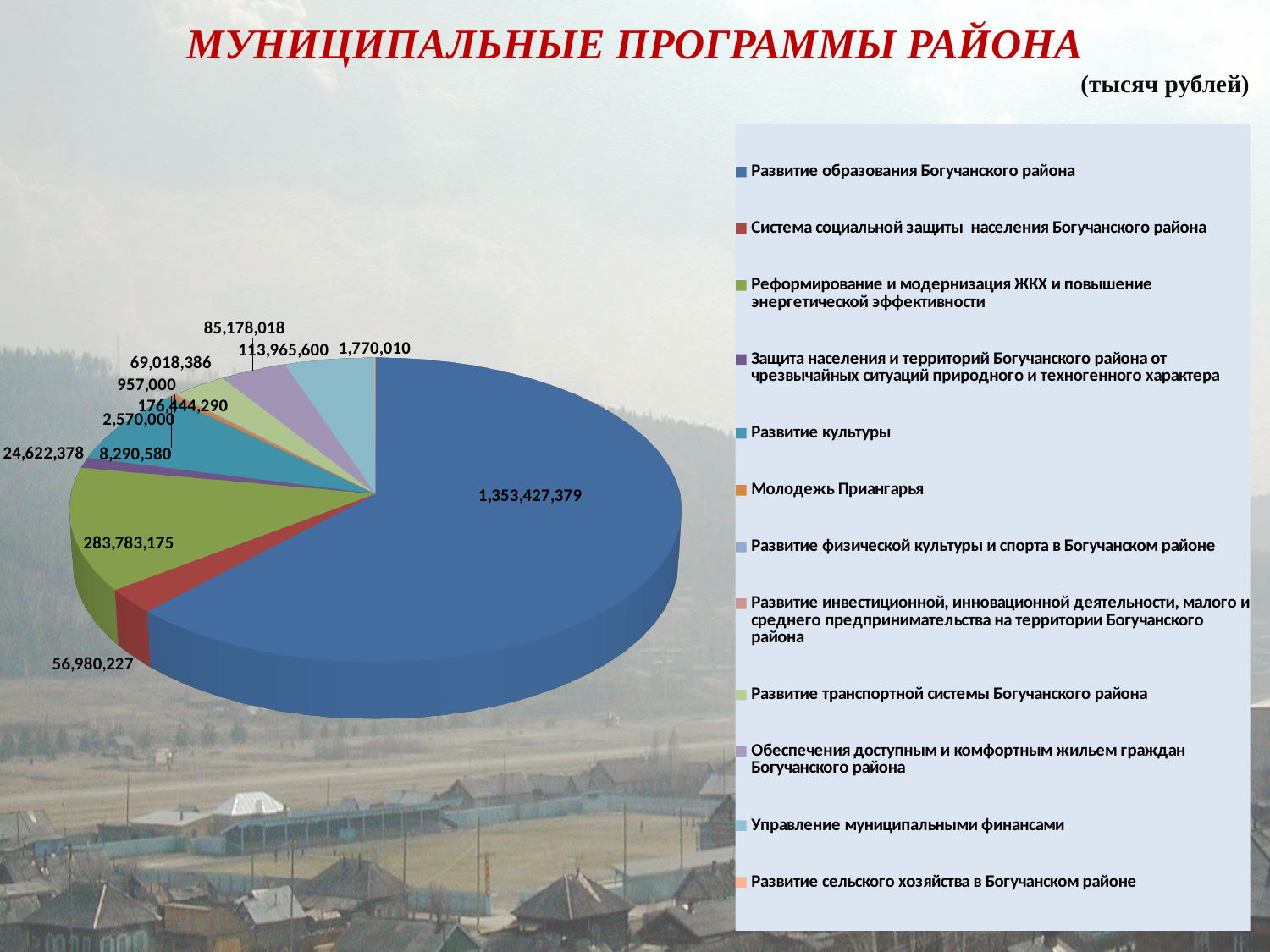
What is the value shown for Развитие образования Богучанского района? 1,353,427,379 What is the title of the chart on the slide? МУНИЦИПАЛЬНЫЕ ПРОГРАММЫ РАЙОНА What is the value shown for Система социальной защиты населения Богучанского района? 56,980,227 What type of chart is shown on the slide? pie chart What is the value shown for Реформирование и модернизация ЖКХ и повышение энергетической эффективности? 283,783,175 Which is larger: the value for Реформирование и модернизация ЖКХ or the value for Развитие культуры? Реформирование и модернизация ЖКХ What is the smallest value printed as a data label on the pie chart? 957,000 What is the difference between the value for Развитие образования Богучанского района and the value for Реформирование и модернизация ЖКХ? 1,069,644,204 How many programmes does the legend of the pie chart list? 12 Which programme has the largest slice of the pie chart? Развитие образования Богучанского района What is the value shown for Развитие культуры? 176,444,290 In what units are the values on the chart given, according to the slide? тысяч рублей